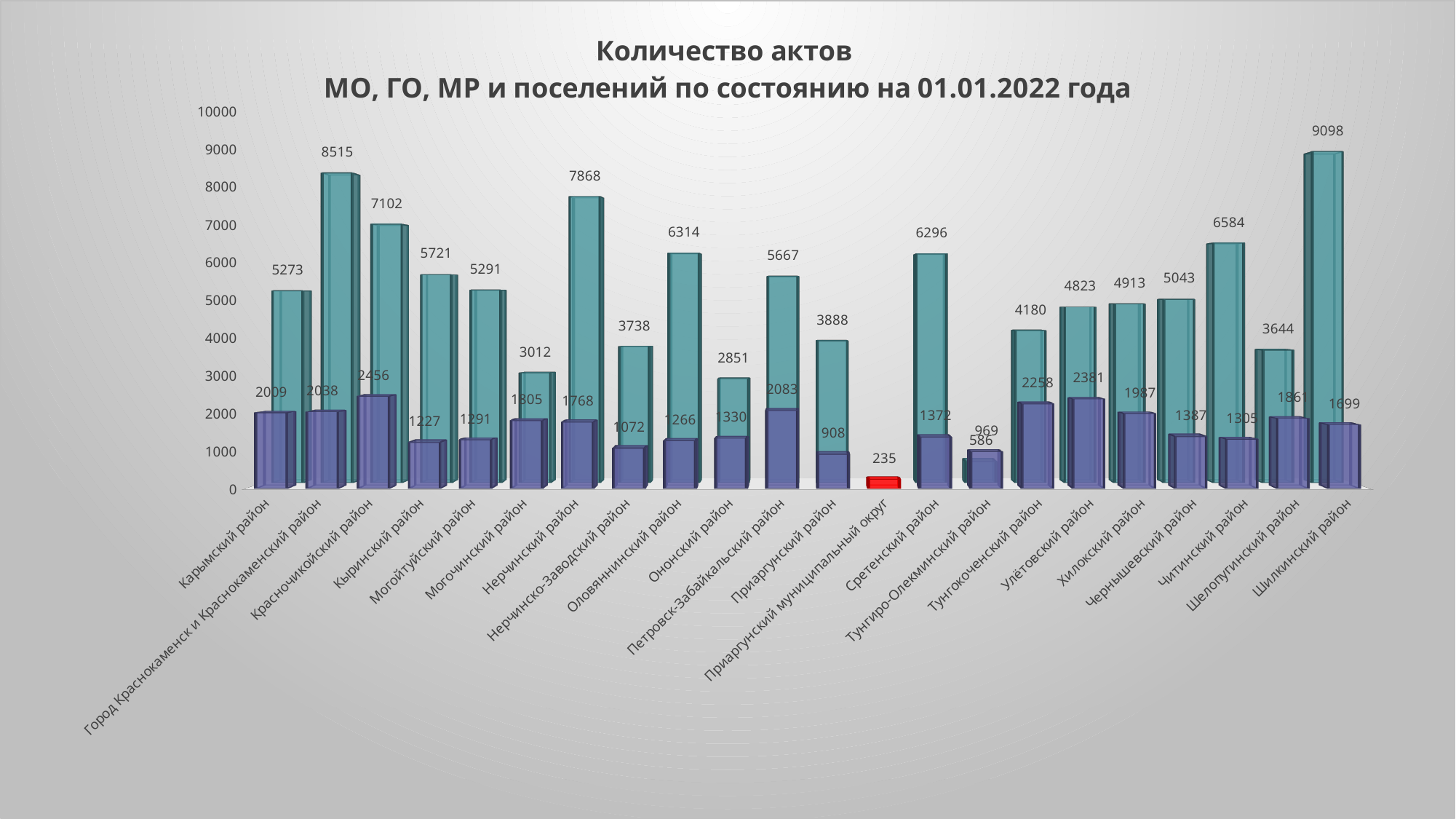
Which district has the lowest teal bar? Тунгиро-Олекминский район Which district has the highest teal bar? Шилкинский район What is the difference between the teal bar values for Шилкинский район (9098) and Город Краснокаменск и Краснокаменский район (8515)? 583 How many districts (categories) are shown on the x axis? 22 What is the title of the chart? Количество актов МО, ГО, МР и поселений по состоянию на 01.01.2022 года Which district has the highest purple bar? Красночикойский район What is the value shown for Приаргунский муниципальный округ? 235 What is the value of the purple bar for Красночикойский район? 2456 What type of chart is shown on the slide? bar chart What is the value of the teal bar for Шилкинский район? 9098 Which is larger: the teal bar for Нерчинский район or the teal bar for Оловяннинский район? Нерчинский район What colour is the bar for Приаргунский муниципальный округ? red